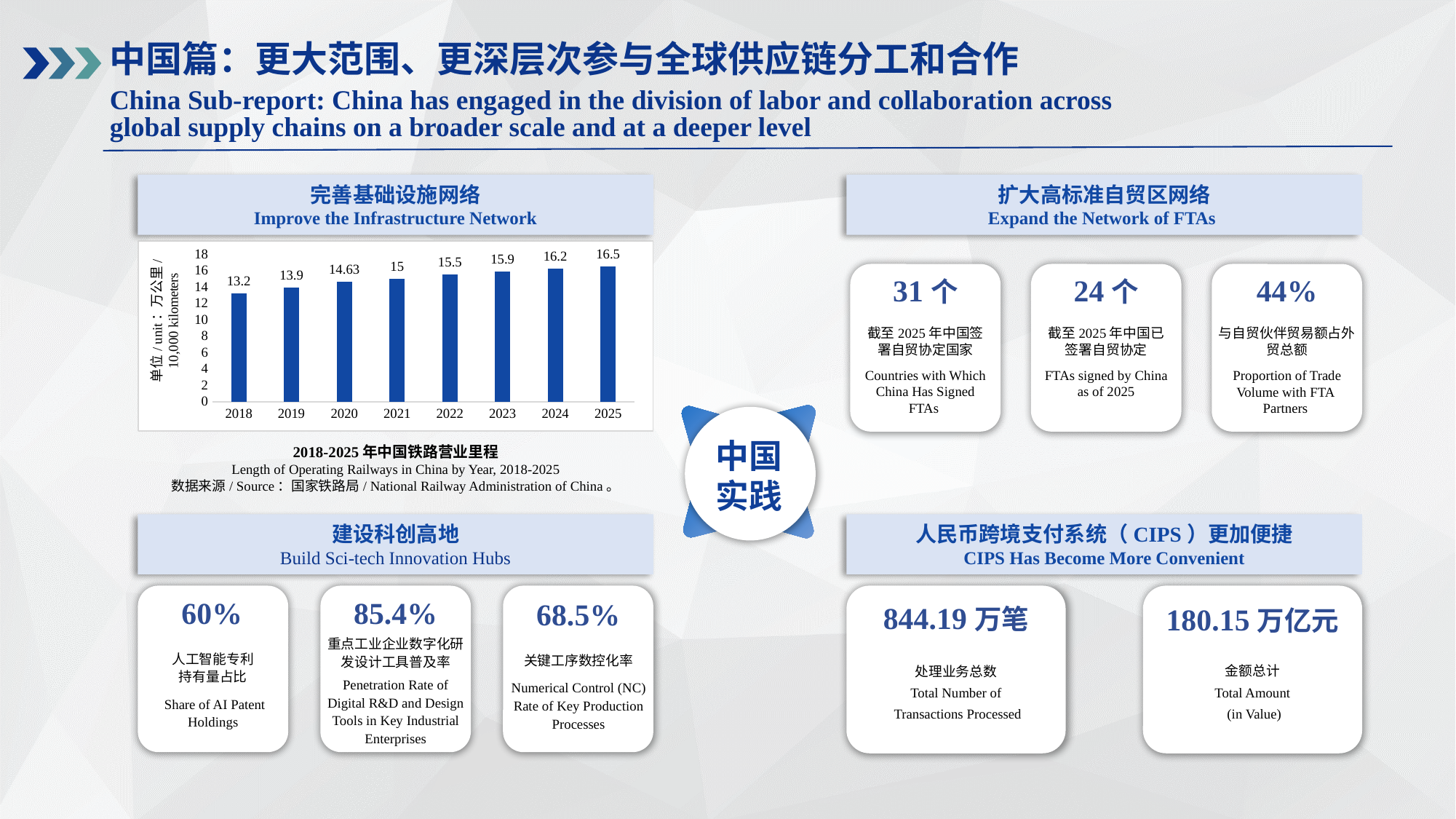
Which year has the highest value in the railway length chart? 2025 What unit is given on the y axis of the railway length chart? 万公里 / 10,000 kilometers How many years (bars) are plotted in the railway length chart? 8 What is the difference between the 2025 value and the 2018 value in the railway chart? 3.3 What is the length of operating railways in China shown for 2020? 14.63 Which year has a larger value, 2023 or 2019? 2023 What is the difference between the 2022 and 2021 values in the railway chart? 0.5 What value is labelled on the 2018 bar? 13.2 What type of chart is used to show the length of operating railways? Bar chart What value does the bar for 2025 show in the railway chart? 16.5 Which year has the lowest value in the railway length chart? 2018 Do the values in the railway length chart rise or fall from 2018 to 2025? Rise